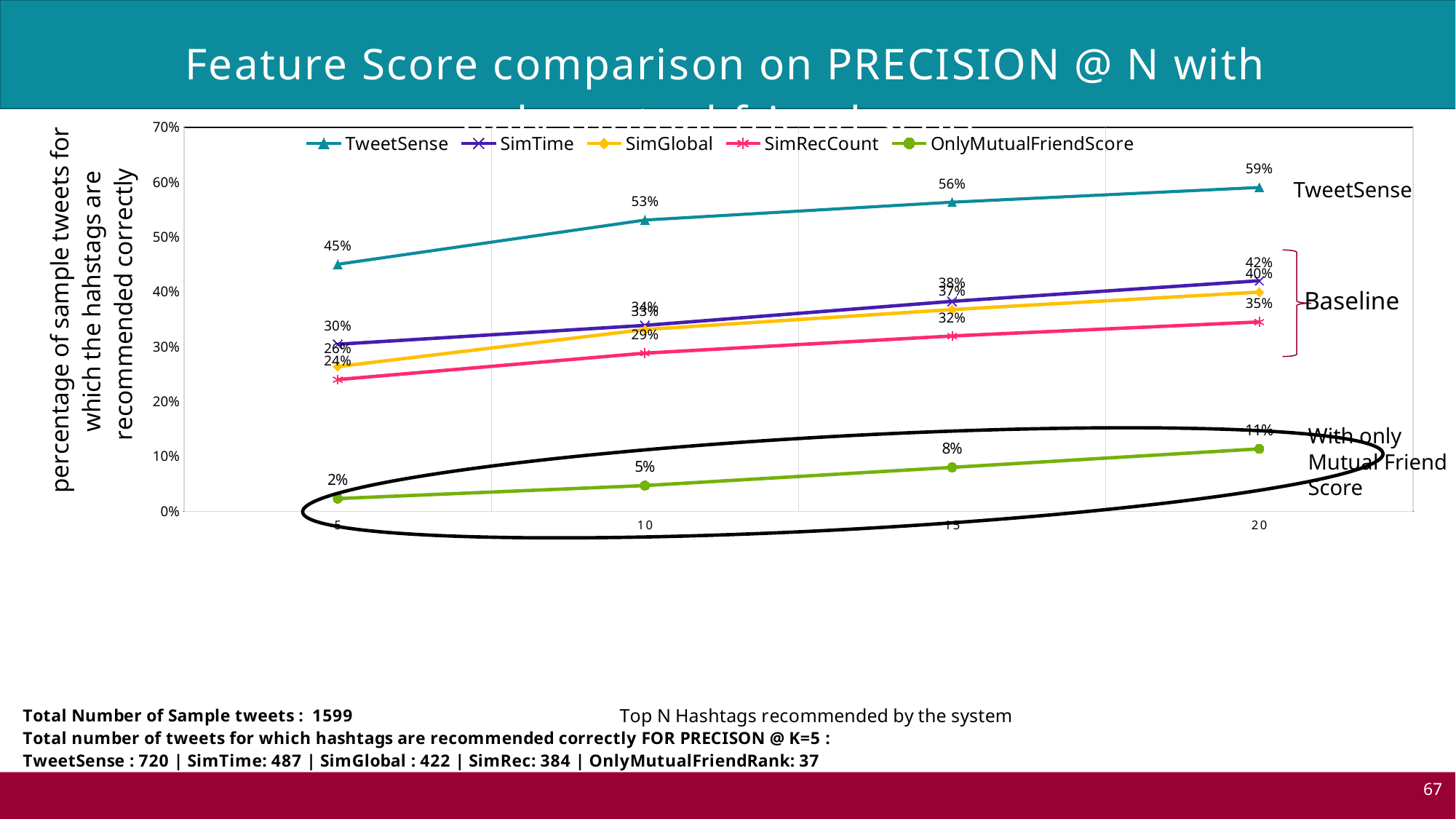
Which series has the lowest value at N = 10? OnlyMutualFriendScore What is the value for SimTime at N = 5? 30% What is the difference between TweetSense and SimTime at N = 20? 17% Which series has the highest value at N = 20? TweetSense What is the value for TweetSense at N = 20? 59% What type of chart is shown on the slide? line chart What is the value for OnlyMutualFriendScore at N = 15? 8% Does the TweetSense line rise or fall as N increases from 5 to 20? rise What is the value for SimRecCount at N = 20? 35% How many series does the legend list? 5 What is the value for TweetSense at N = 5? 45% Which is larger at N = 5: SimGlobal or SimRecCount? SimGlobal